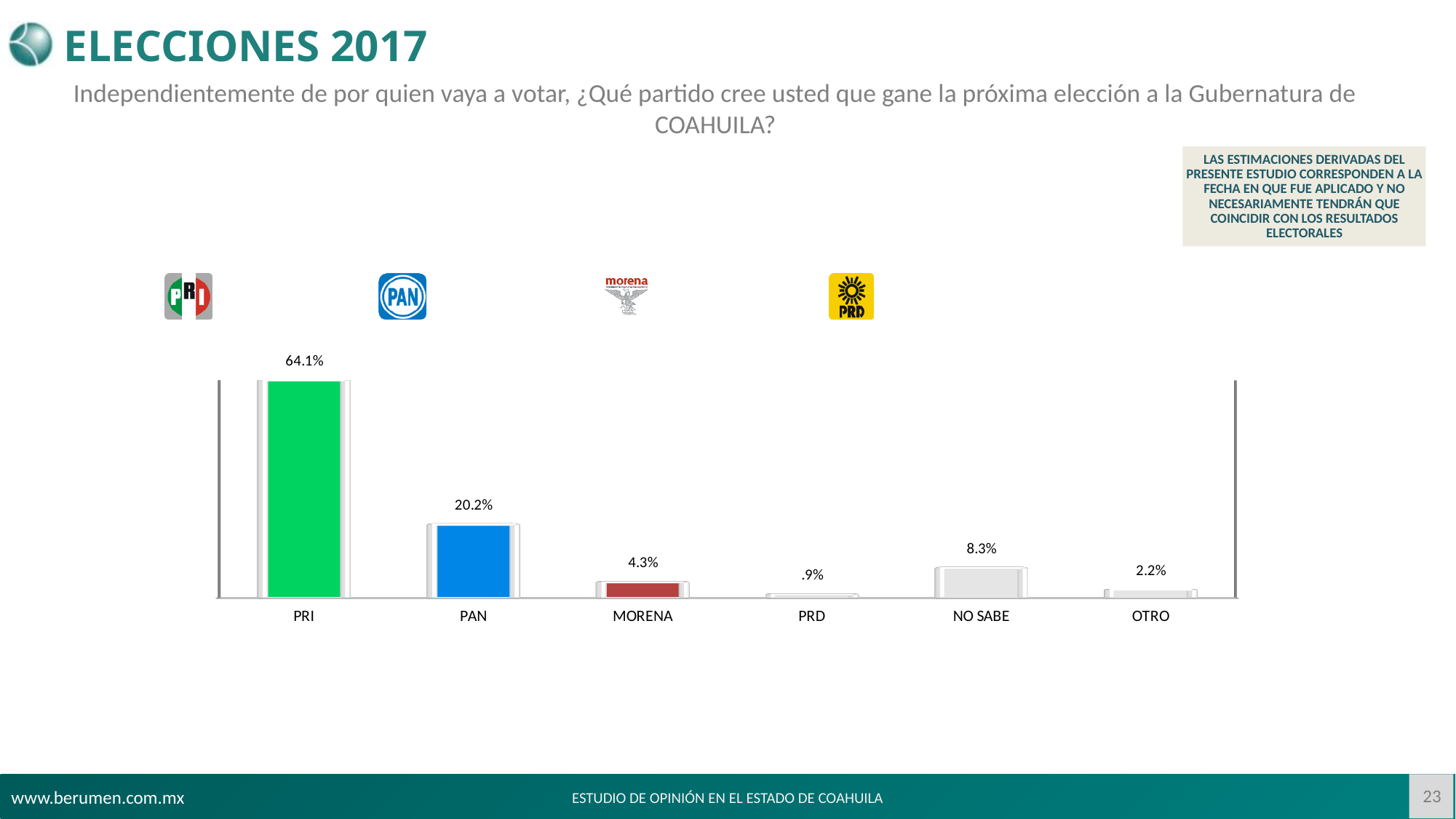
What is the value shown for MORENA? 4.3% How many categories are shown on the chart? 6 What is the value shown for PAN? 20.2% Which is larger, the value for NO SABE or the value for MORENA? NO SABE What is the value shown for PRD? .9% What is the value shown for NO SABE? 8.3% What kind of chart is shown on the slide? Bar chart What percentage of respondents believe PRI will win the next election for Governor of Coahuila? 64.1% Which category has the lowest value? PRD What is the difference in percentage points between PRI and PAN? 43.9 Which category has the highest value? PRI What is the value shown for OTRO? 2.2%